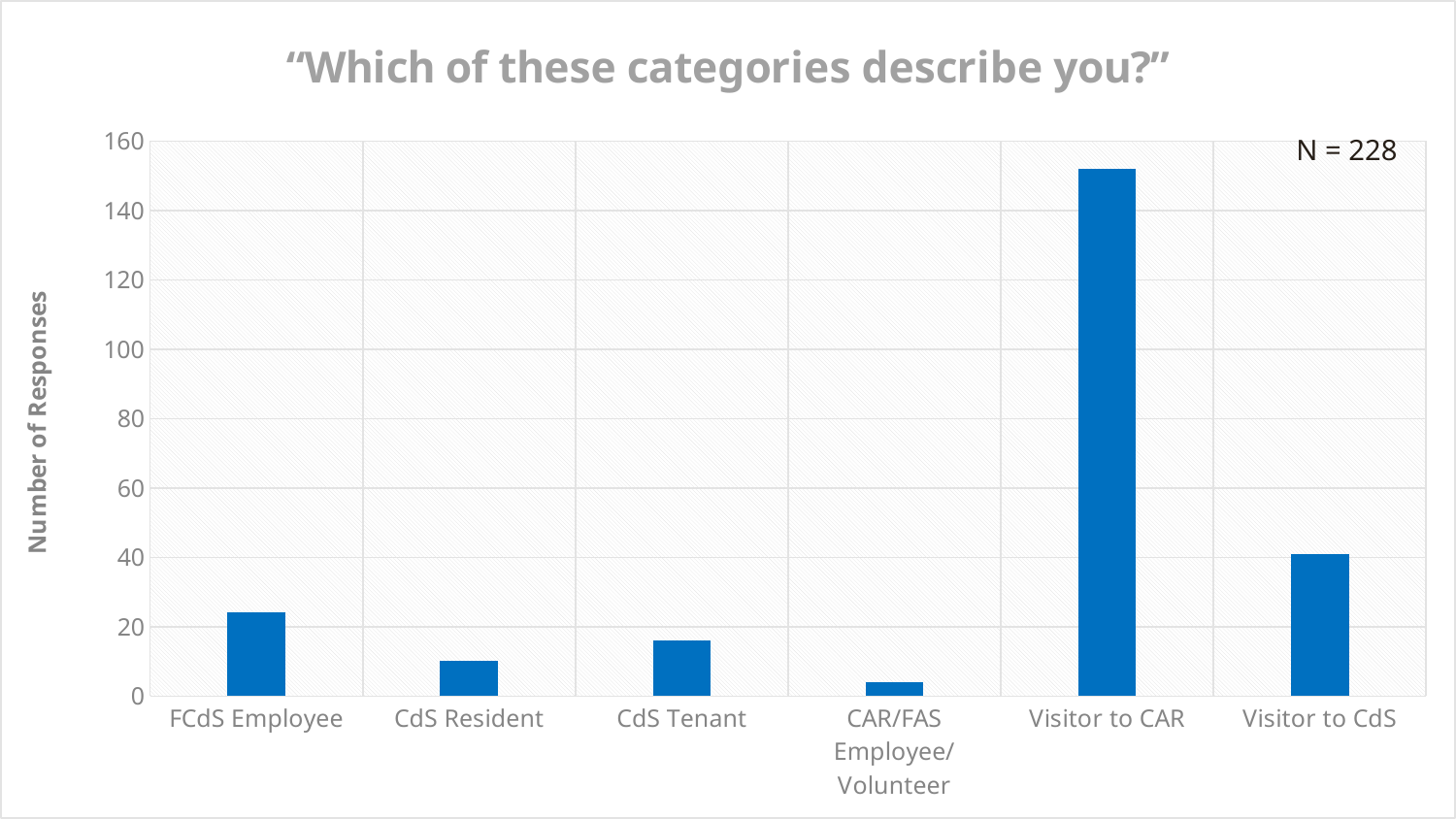
Is the value for CAR/FAS Employee/Volunteer greater or less than 20? less Which category has the lowest number of responses? CAR/FAS Employee/Volunteer What type of chart is shown on the slide? bar chart How many categories are shown on the x axis? 6 Is the value for FCdS Employee greater or less than 20? greater Is the value for CdS Tenant greater or less than 20? less Which has more responses, FCdS Employee or CdS Tenant? FCdS Employee What is the title of the chart? "Which of these categories describe you?" Which has more responses, CdS Resident or Visitor to CdS? Visitor to CdS Which category has the highest number of responses? Visitor to CAR